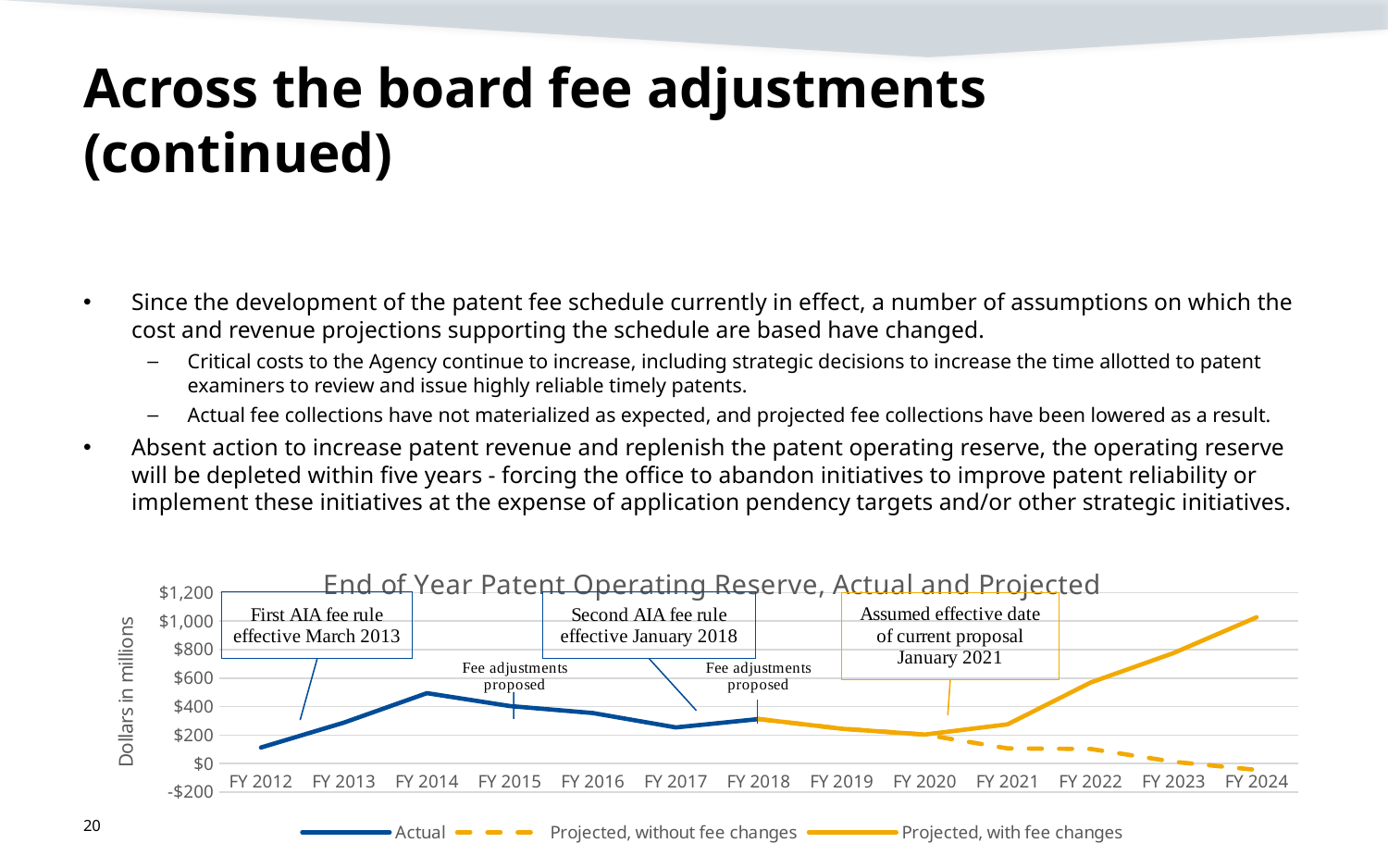
Is the Actual value for FY 2014 greater or less than $400? greater How many fiscal years are shown on the x axis of the chart? 13 In which fiscal year does the Actual series have its lowest value? FY 2012 How many series does the chart legend list? 3 Does the 'Projected, with fee changes' series rise or fall from FY 2021 to FY 2024? Rises Is the 'Projected, without fee changes' value for FY 2024 greater or less than $200? less What type of chart is shown on the slide? Line chart In which fiscal year does the Actual series reach its highest value? FY 2014 What is the label of the vertical axis of the chart? Dollars in millions Is the Actual value for FY 2012 greater or less than $200? less What is the title of the chart? End of Year Patent Operating Reserve, Actual and Projected